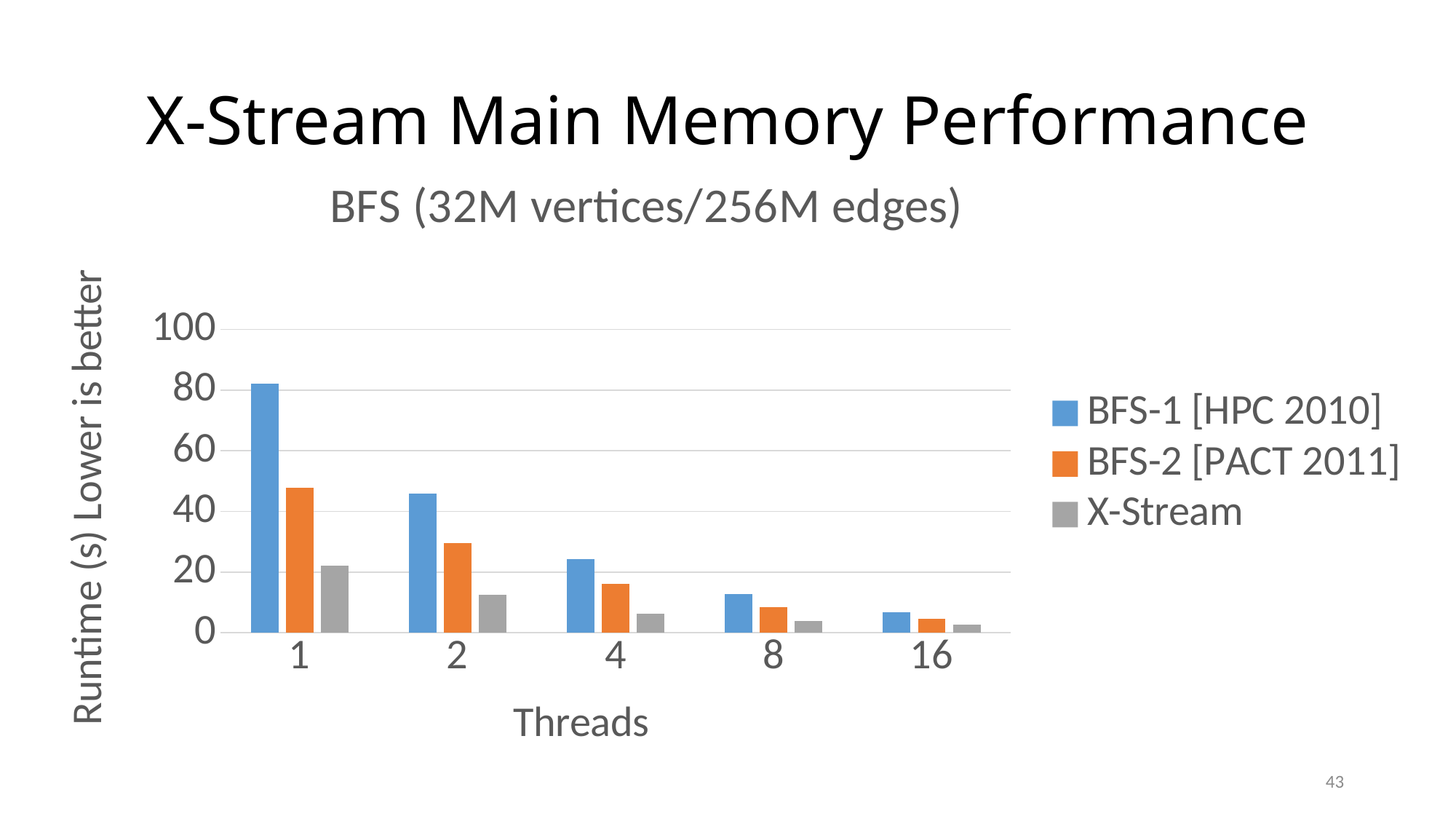
Is the runtime for X-Stream at 2 threads greater or less than 20? less How many series does the legend list? 3 What is the label of the y axis? Runtime (s) Lower is better Which series has the highest runtime at 1 thread? BFS-1 [HPC 2010] Is the runtime for BFS-1 [HPC 2010] at 1 thread greater or less than 80? greater Which is larger at 8 threads, the runtime for BFS-2 [PACT 2011] or for X-Stream? BFS-2 [PACT 2011] How many thread counts are shown on the x axis? 5 Is the runtime for BFS-2 [PACT 2011] at 1 thread greater or less than 40? greater What kind of chart is shown on the slide? bar chart Does the runtime for BFS-1 [HPC 2010] rise or fall as the number of threads increases? fall Which series has the lowest runtime at 1 thread? X-Stream